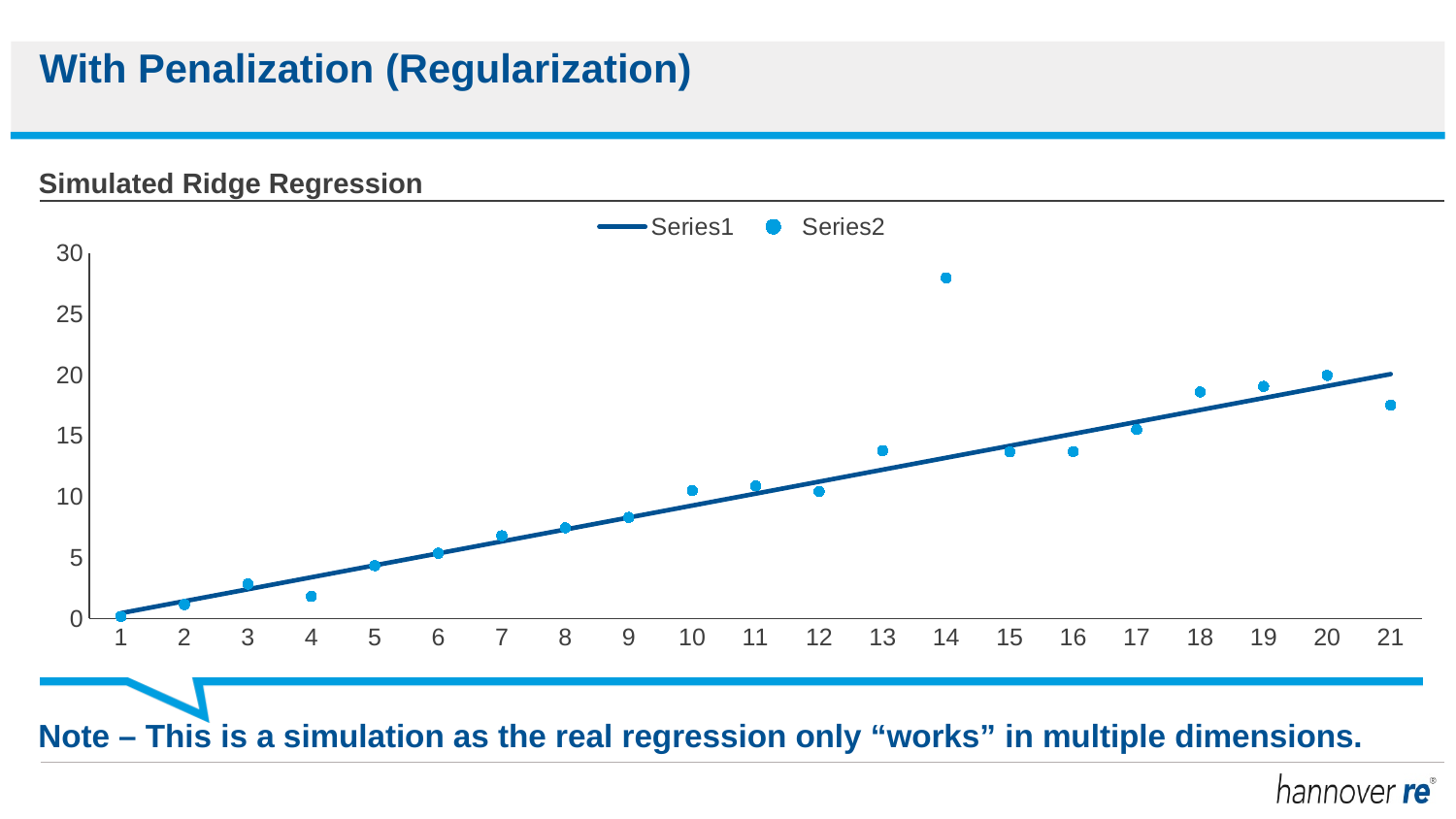
What kind of chart is shown under the title "Simulated Ridge Regression"? A line chart with a scatter of points Is the Series2 value at x = 16 greater or less than 15? less Is the Series2 value at x = 14 greater or less than 25? greater Is the Series2 value at x = 21 greater or less than 15? greater What is the title of the chart? Simulated Ridge Regression How many x-axis categories are shown on the chart? 21 Which is larger for Series2: the value at x = 20 or at x = 21? x = 20 Does the Series1 line rise or fall as x increases from 1 to 21? rise At which x value does Series2 have its lowest point? 1 How many series does the legend list? 2 At which x value does Series2 reach its highest point? 14